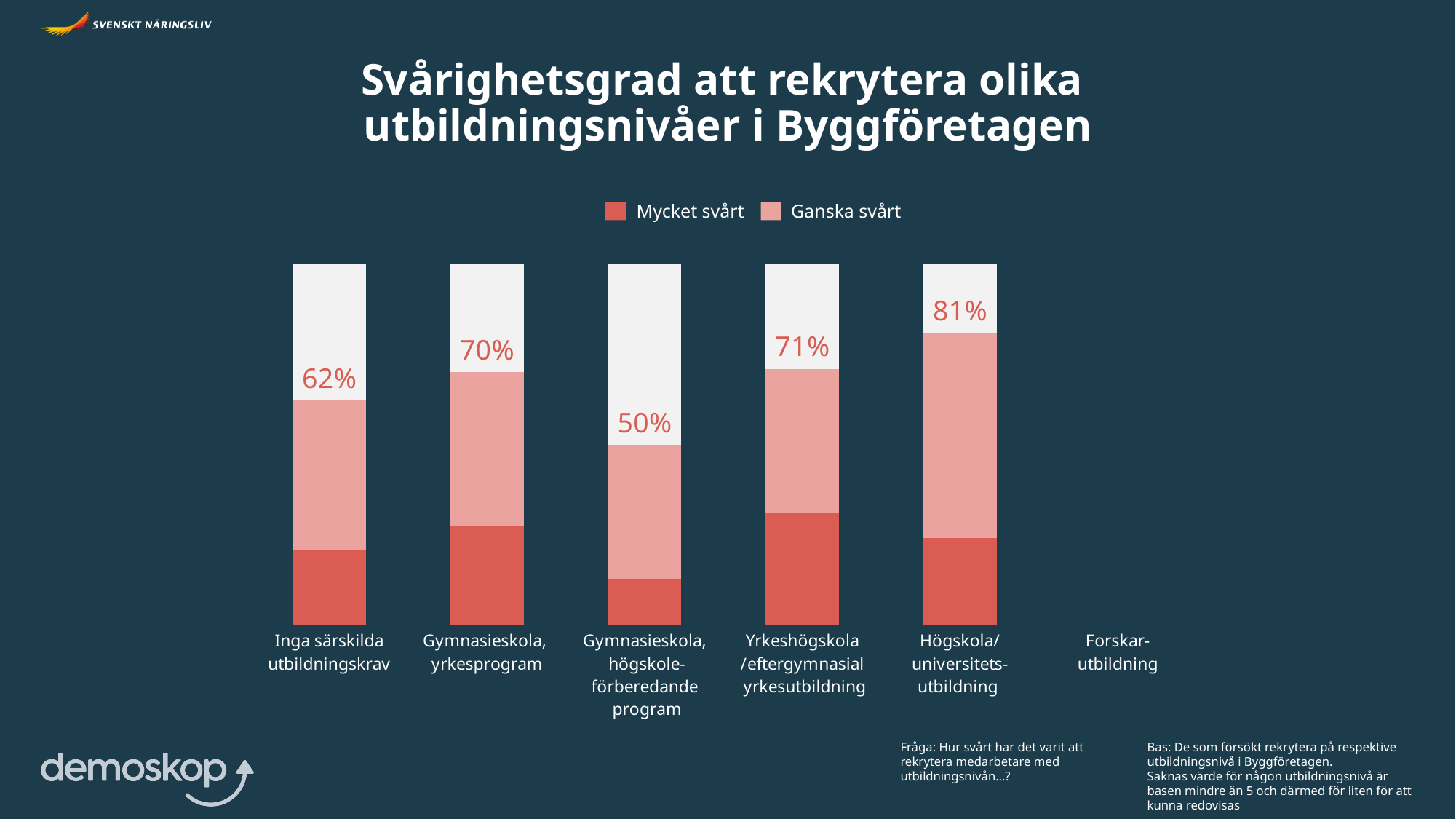
What kind of chart is shown on the slide? Stacked bar chart What is the total percentage shown for Gymnasieskola, högskoleförberedande program? 50% Which has a larger total percentage: Gymnasieskola, yrkesprogram or Inga särskilda utbildningskrav? Gymnasieskola, yrkesprogram What is the difference between the total for Högskola/universitetsutbildning and the total for Gymnasieskola, högskoleförberedande program? 31% How many bars are plotted in the chart? 5 How many series does the legend list? 2 What is the total percentage shown for Inga särskilda utbildningskrav? 62% Which education level with a plotted bar has the lowest total percentage? Gymnasieskola, högskoleförberedande program Which category on the x axis has no bar plotted? Forskarutbildning What is the total percentage shown for Yrkeshögskola/eftergymnasial yrkesutbildning? 71% Which education level has the highest total percentage? Högskola/universitetsutbildning What is the total percentage shown for Högskola/universitetsutbildning? 81%